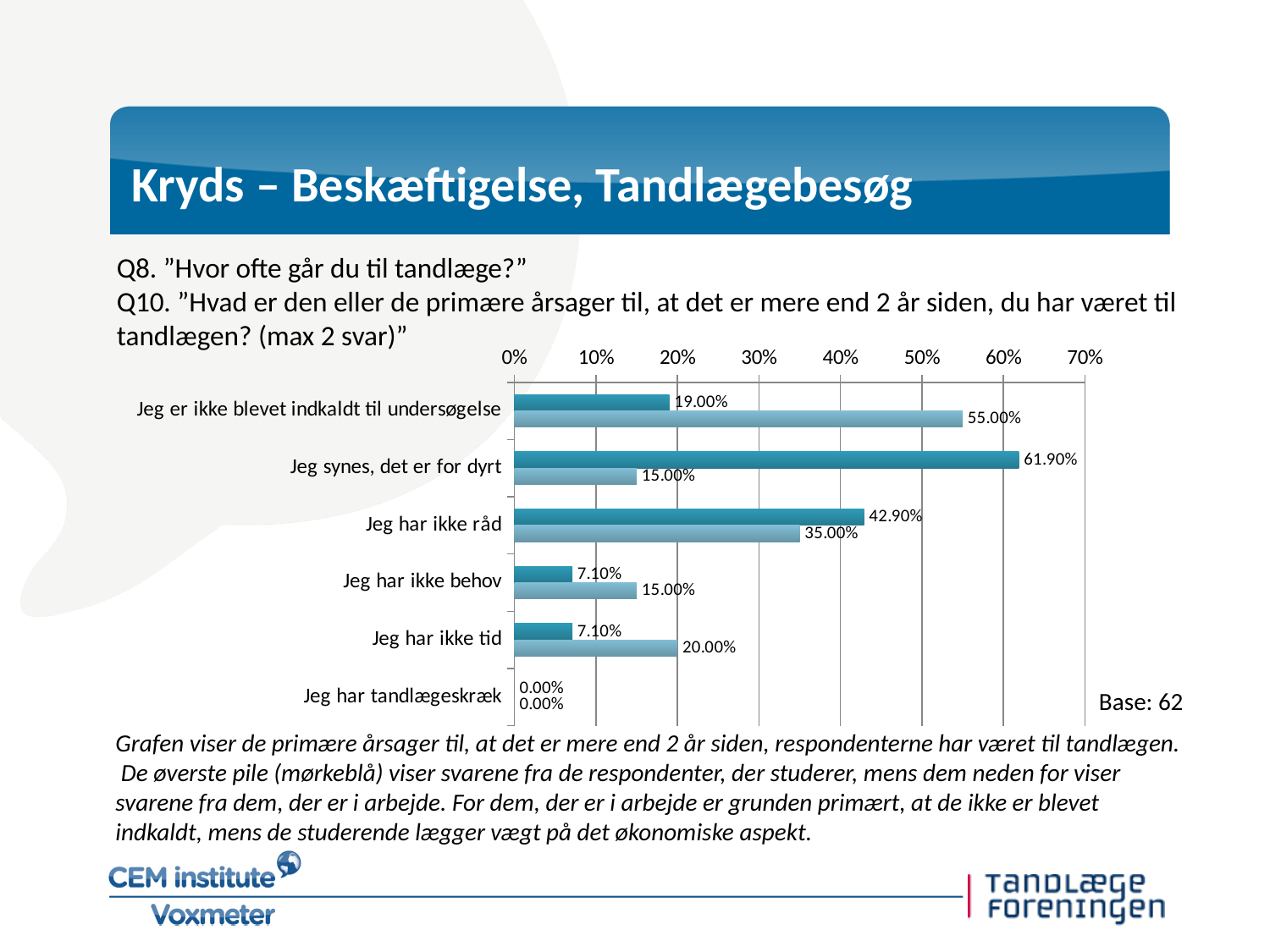
What is the value of the dark blue (upper) bar for "Jeg har ikke råd"? 42.90% What is the value of the light blue (lower) bar for "Jeg har ikke tid"? 20.00% Which category has the lowest values for both bars? Jeg har tandlægeskræk What is the difference between the dark blue and light blue bars for "Jeg synes, det er for dyrt"? 46.90% Which category has the highest value among the light blue (lower) bars? Jeg er ikke blevet indkaldt til undersøgelse What kind of chart is shown on the slide? bar chart What is the value of the light blue (lower) bar for "Jeg er ikke blevet indkaldt til undersøgelse"? 55.00% How many categories (reasons) are listed on the chart? 6 What is the value of the dark blue (upper) bar for "Jeg synes, det er for dyrt"? 61.90% What base (number of respondents) is stated next to the chart? Base: 62 For "Jeg har ikke behov", which bar is larger, the dark blue (upper) or the light blue (lower)? light blue (lower) Which category has the highest value among the dark blue (upper) bars? Jeg synes, det er for dyrt